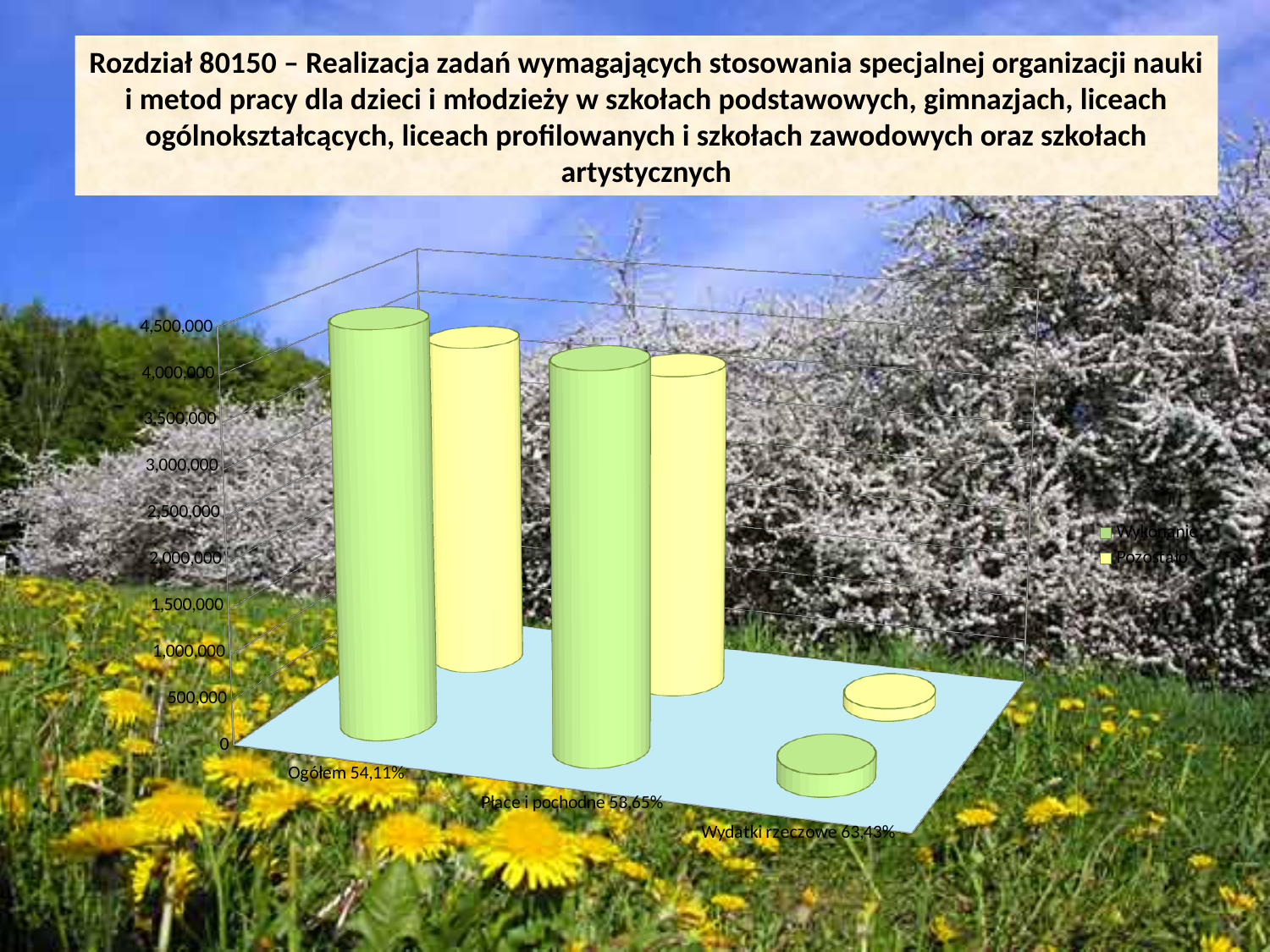
What are the two series named in the chart's legend? Wykonanie and Pozostało Is the Wykonanie value for Wydatki rzeczowe greater or less than 500,000? less Which category has the lowest Wykonanie value? Wydatki rzeczowe What percentage is printed next to the category label "Ogółem"? 54,11% Which is larger: the Wykonanie value for Płace i pochodne or the Wykonanie value for Wydatki rzeczowe? Płace i pochodne How many series does the chart's legend list? 2 Which category has the highest Wykonanie value? Ogółem Do the Wykonanie values rise or fall moving from Ogółem to Wydatki rzeczowe along the x axis? fall Is the Wykonanie value for Ogółem greater or less than 2,000,000? greater Is the Pozostało value for Wydatki rzeczowe greater or less than 500,000? less What kind of chart is shown on the slide? bar chart How many categories are shown on the x axis of the chart? 3